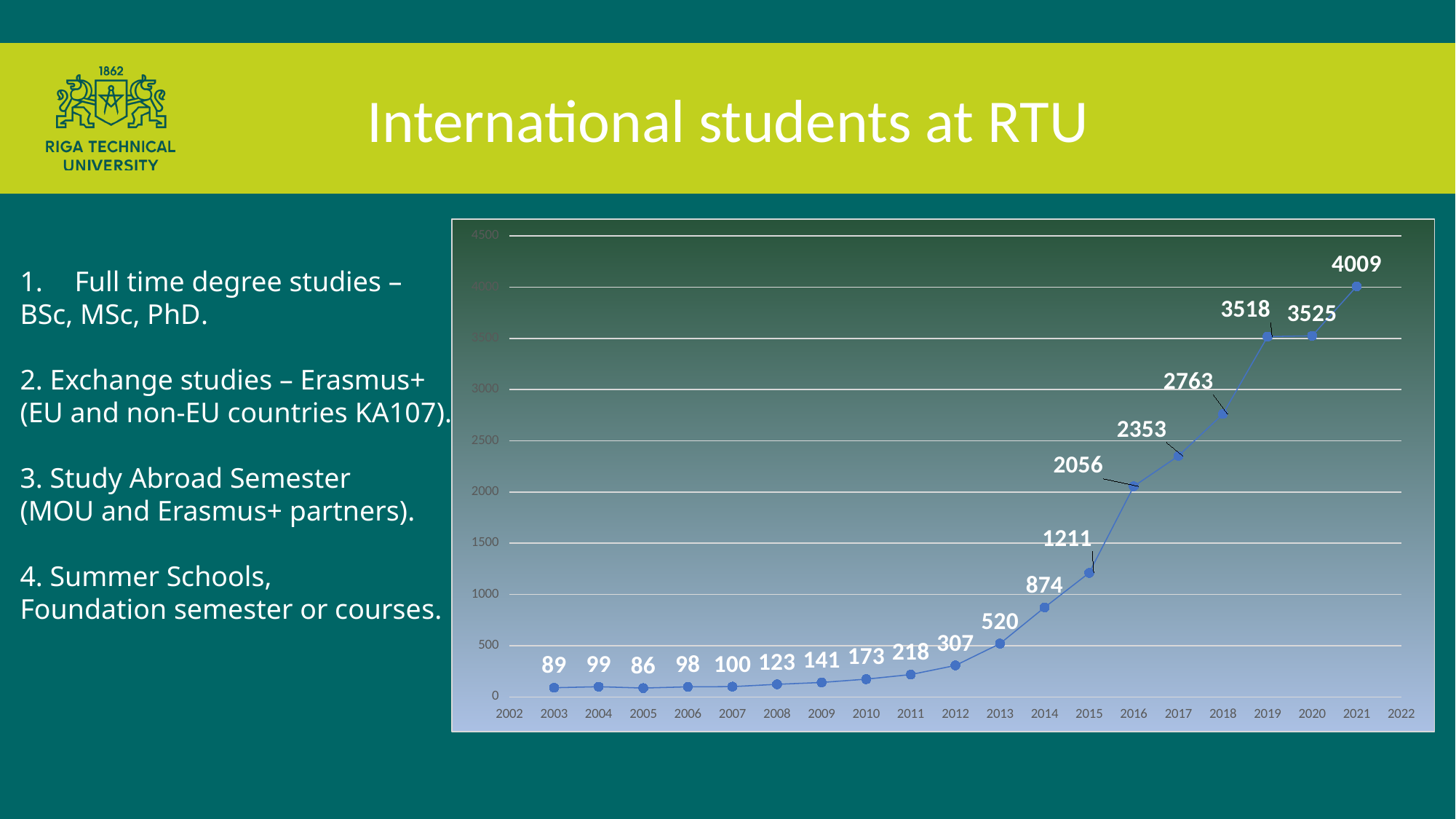
Is the value for 2017 greater or less than 2000? greater What is the value plotted for 2007? 100 Do the values generally rise or fall from 2003 to 2021? rise What kind of chart is shown on the slide? line chart How many data points are plotted on the line? 19 Which year has the highest value? 2021 What is the value plotted for 2021? 4009 Which year has the lowest value? 2005 What is the value plotted for 2016? 2056 What is the difference between the values for 2019 and 2018? 755 What is the value plotted for 2013? 520 Which is larger, the value for 2004 or the value for 2006? 2004